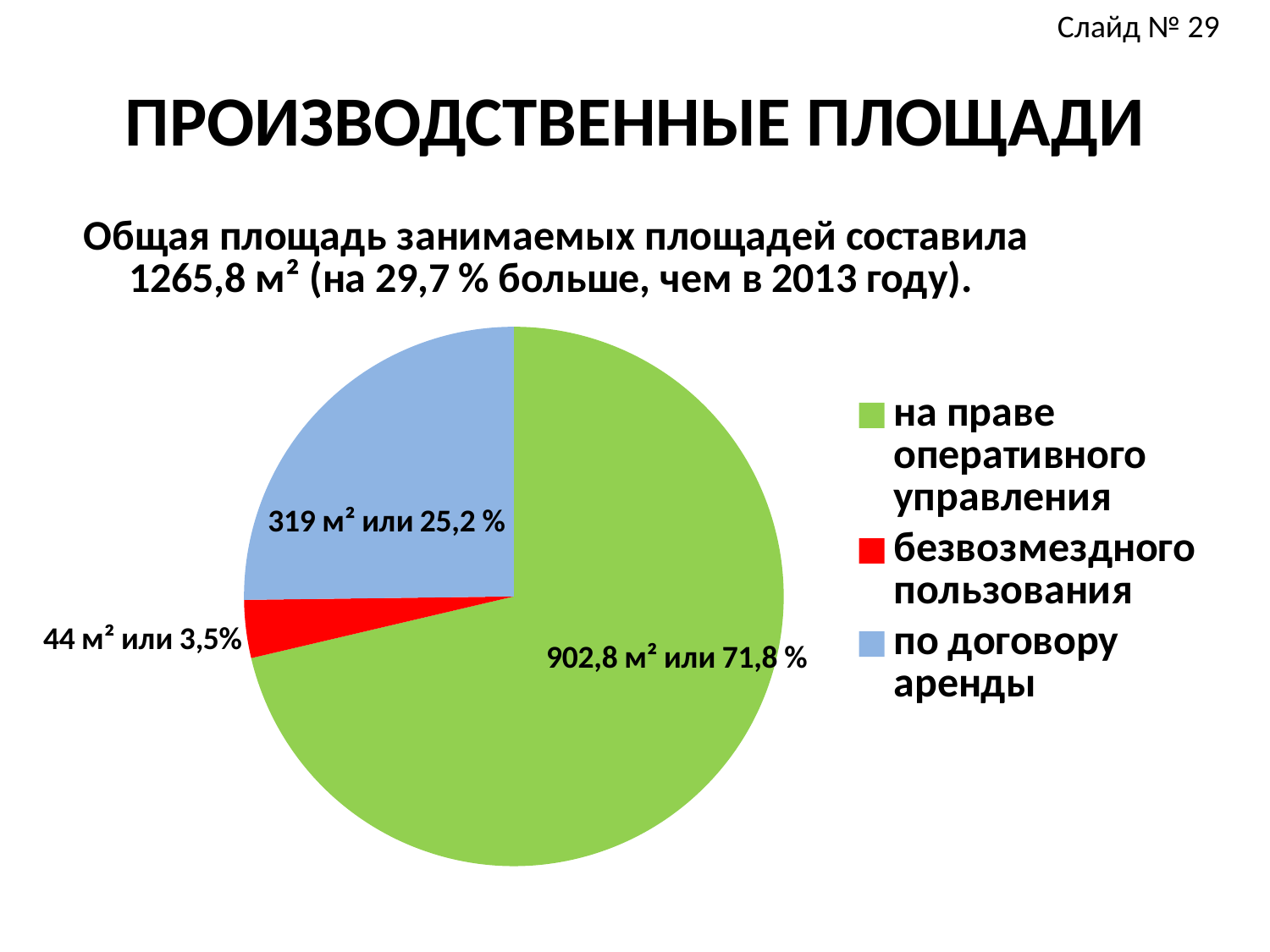
What area is shown for the slice 'по договору аренды'? 319 м² Which category has the largest slice? на праве оперативного управления What area is shown for the slice 'на праве оперативного управления'? 902,8 м² How many entries does the legend list? 3 What share of the pie does 'на праве оперативного управления' take? 71,8 % Which colour represents 'по договору аренды' in the pie chart? light blue How many slices does the pie chart have? 3 What kind of chart is shown on the slide? pie chart What share of the pie does 'безвозмездного пользования' take? 3,5% What share of the pie does 'по договору аренды' take? 25,2 % What area is shown for the slice 'безвозмездного пользования'? 44 м² Which category has the smallest slice? безвозмездного пользования